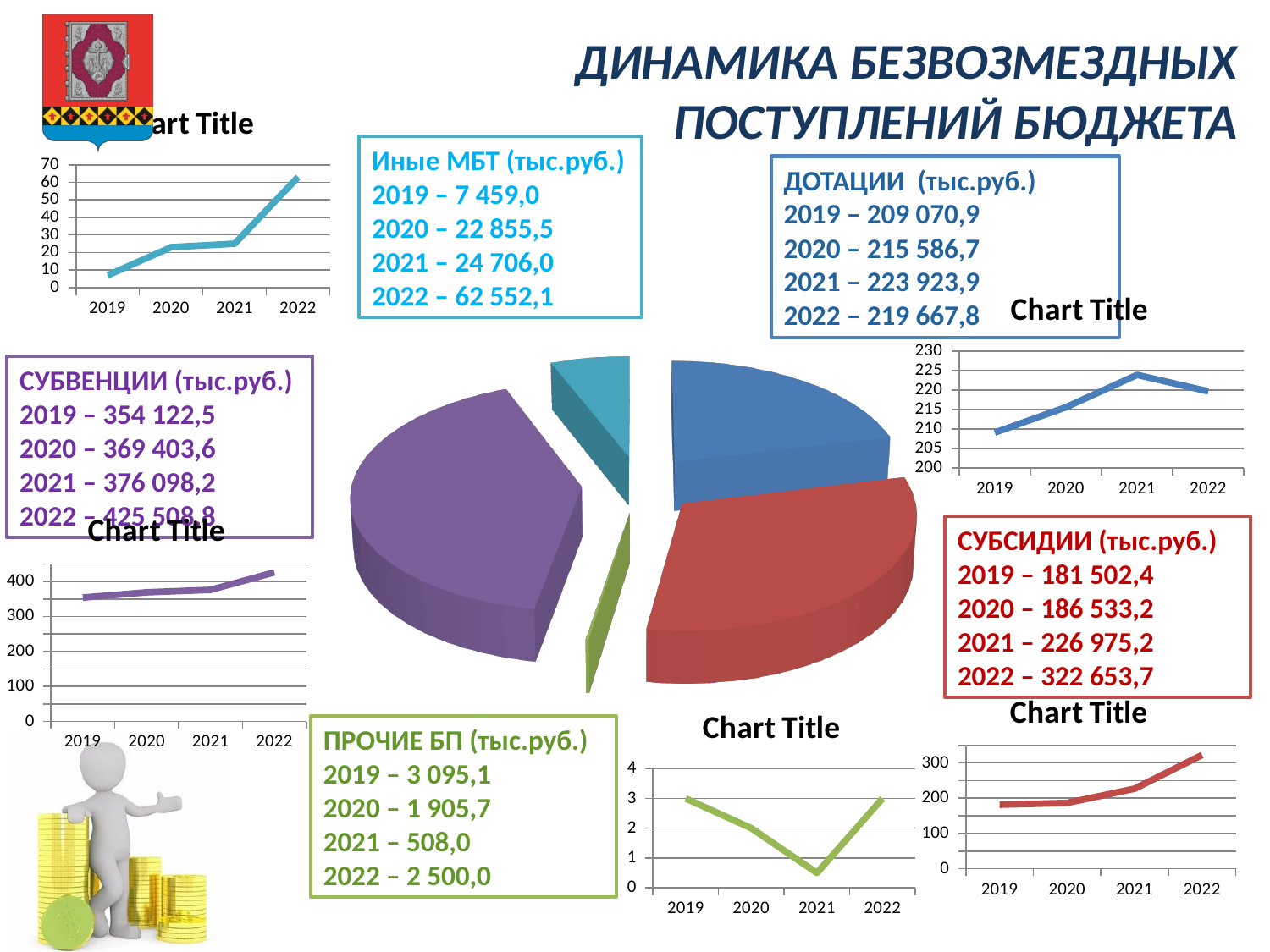
In the red line chart at the bottom right of the slide, is the value for 2022 greater or less than 300? greater What kind of chart is the line chart at the top left of the slide? line chart In the purple line chart on the left of the slide, do the values rise or fall from 2019 to 2022? rise In the green line chart at the bottom middle of the slide, which year has the lowest value? 2021 In the blue line chart at the top right of the slide, is the value for 2021 greater or less than 220? greater What kind of chart is the chart in the centre of the slide? pie chart In the top-left line chart, how many years are shown on the x axis? 4 In the green line chart at the bottom middle of the slide, is the value for 2019 greater or less than 2? greater In the blue line chart at the top right of the slide, which year has the highest value? 2021 How many slices does the pie chart in the centre of the slide have? 5 In the top-left line chart, which year has the highest value? 2022